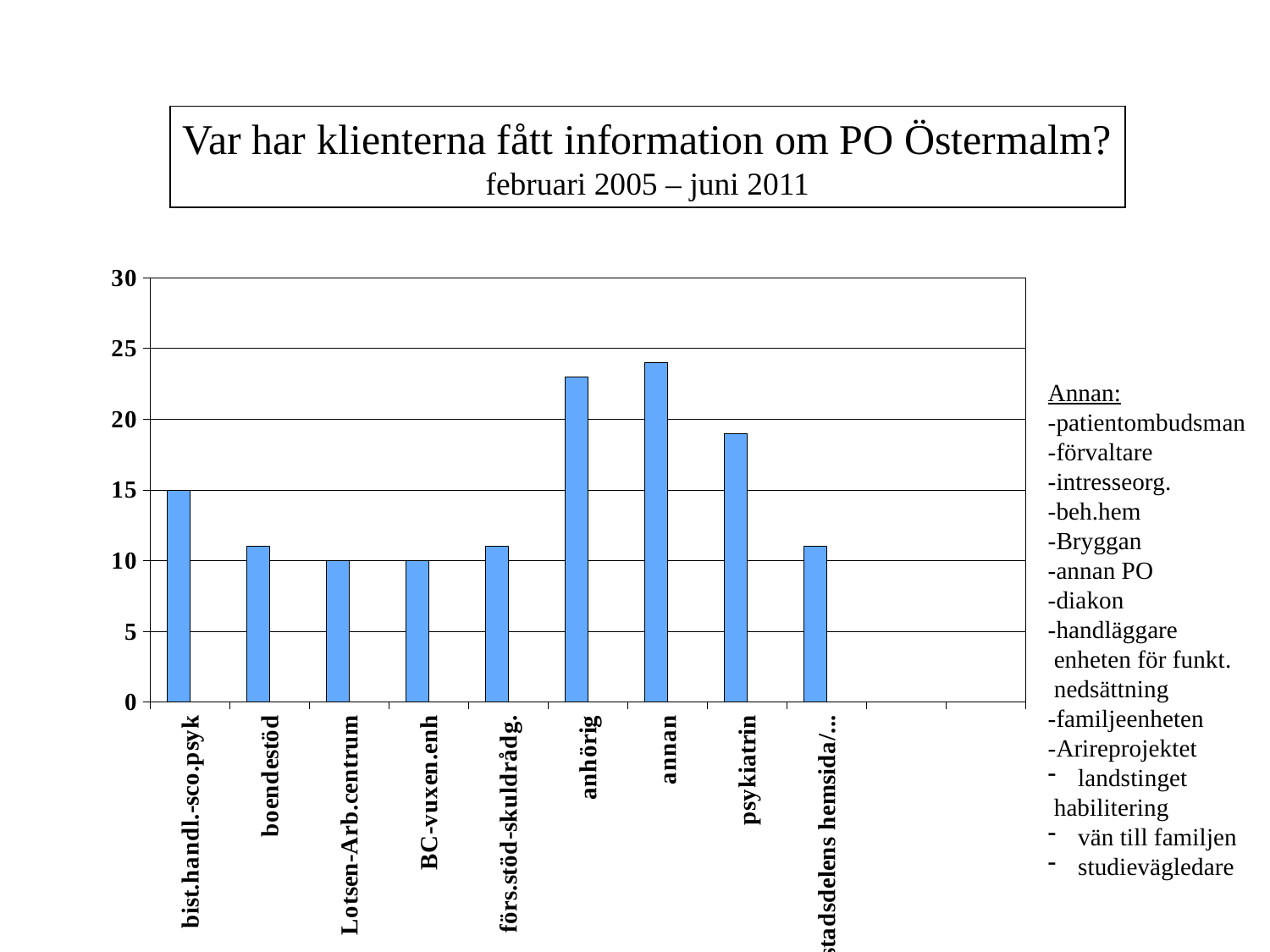
Is the value for annan greater or less than 20? greater How many categories are plotted on the x axis of the chart? 9 What is the value for Lotsen-Arb.centrum? 10 Is the value for boendestöd greater or less than 15? less Is the value for anhörig greater or less than 20? greater Which is larger, the value for psykiatrin or the value for förs.stöd-skuldrådg.? psykiatrin What time period does the chart title say the data covers? februari 2005 – juni 2011 What is the value for BC-vuxen.enh? 10 What is the value for bist.handl.-sco.psyk? 15 What kind of chart is shown on the slide? bar chart Which is larger, the value for anhörig or the value for bist.handl.-sco.psyk? anhörig